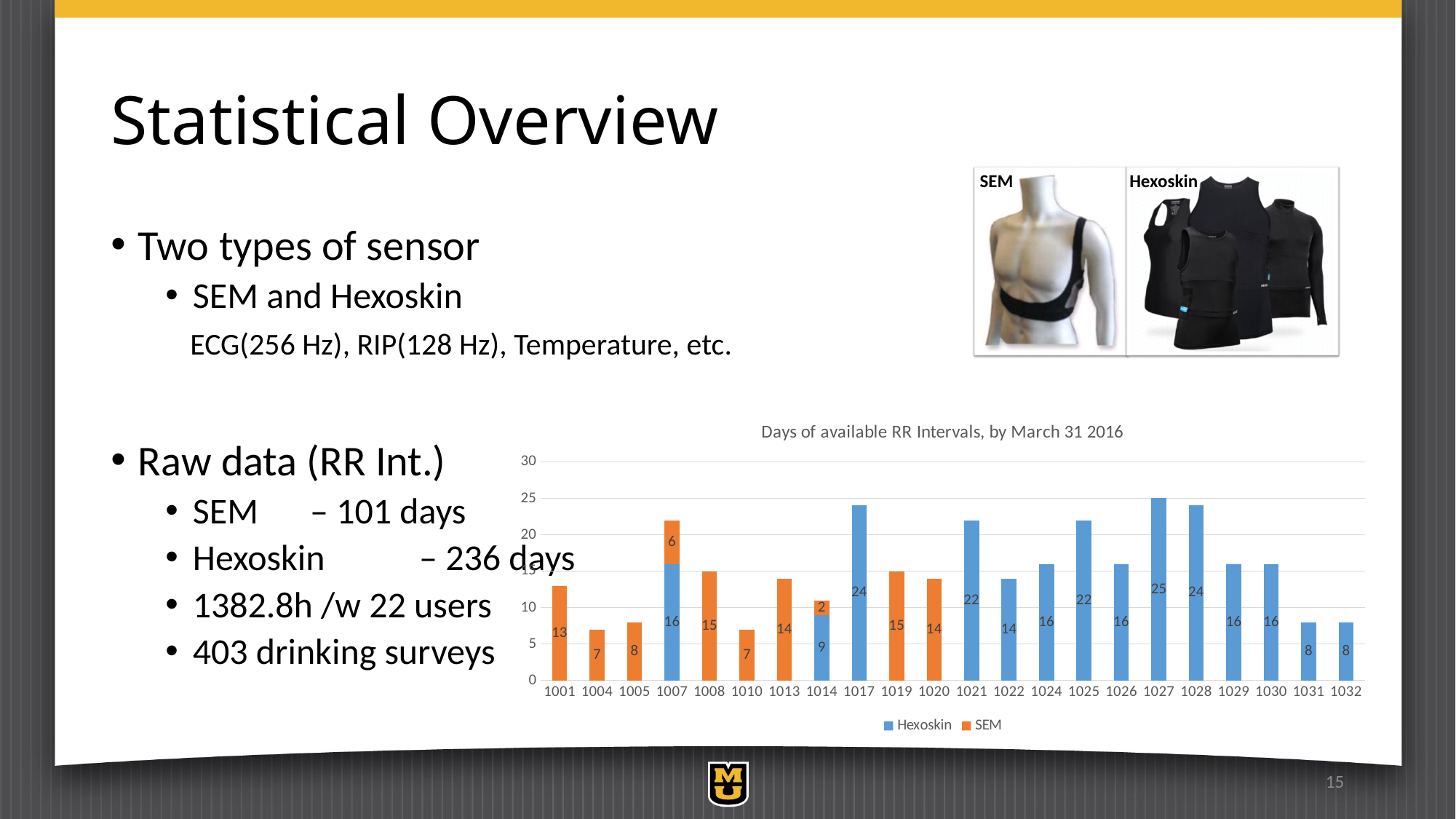
How many user IDs are shown on the x axis of the chart? 22 What is the title of the chart? Days of available RR Intervals, by March 31 2016 How many series does the chart legend list? 2 What is the difference between the Hexoskin values for users 1027 and 1022? 11 What is the total stacked value for user 1007? 22 Which user has the lowest SEM value? 1014 What is the SEM value for user 1001? 13 Which is larger, the SEM value for user 1008 or the SEM value for user 1005? 1008 What is the SEM value for user 1007? 6 What kind of chart is shown on the slide? bar chart Which user has the highest Hexoskin value? 1027 What is the Hexoskin value for user 1017? 24